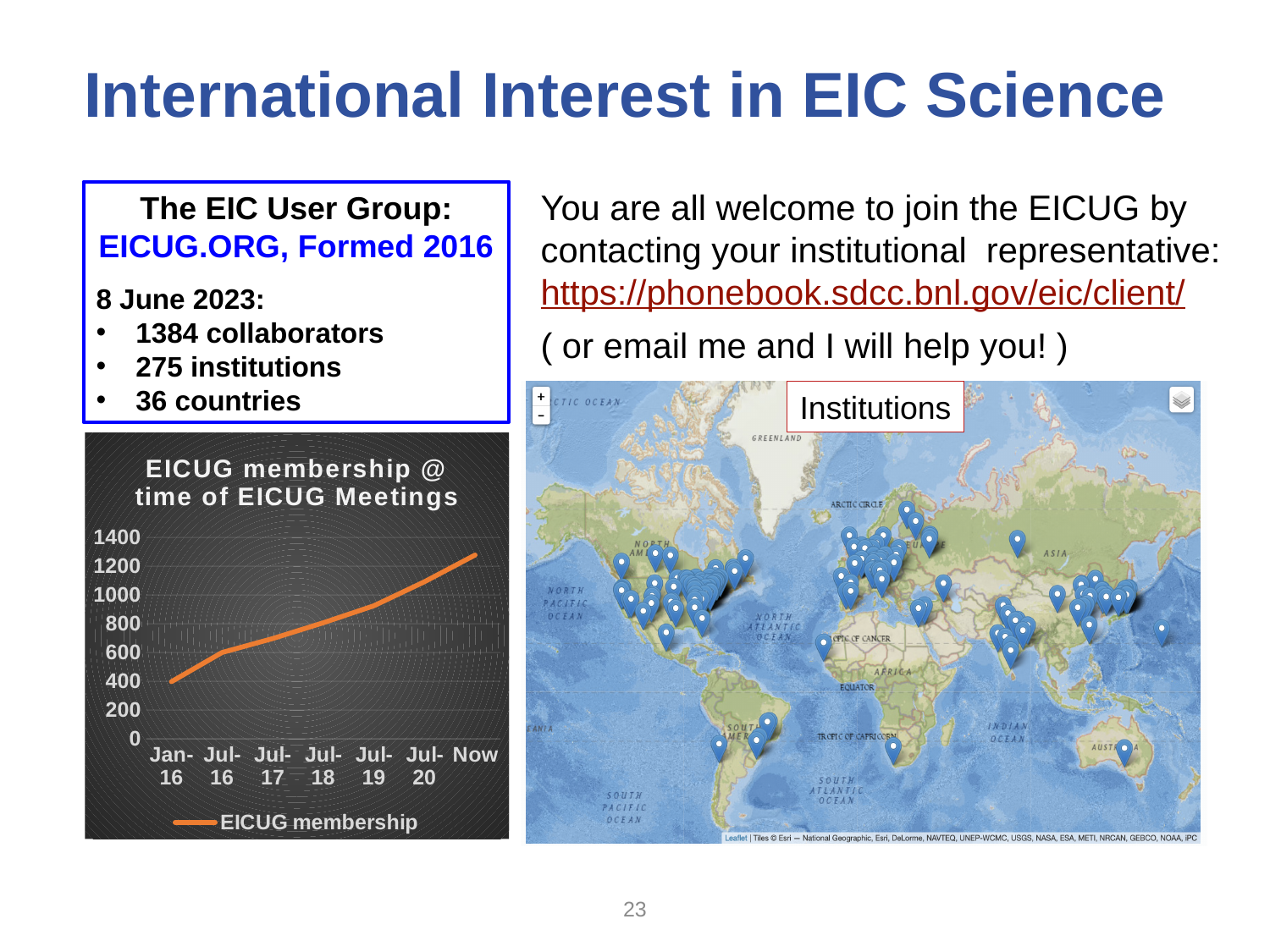
In the EICUG membership chart, which is larger, the value for Jul-20 or the value for Jul-17? Jul-20 In the EICUG membership chart, is the value for Now greater or less than 1200? greater What is the title of the chart on the left of the slide? EICUG membership @ time of EICUG Meetings In the EICUG membership chart, is the value for Jul-19 greater or less than 800? greater Which point on the EICUG membership chart has the lowest value? Jan-16 What kind of chart is the EICUG membership chart on the slide? line chart How many series does the legend of the EICUG membership chart list? 1 How many data points are plotted along the x axis of the EICUG membership chart? 7 Which point on the EICUG membership chart has the highest value? Now In the EICUG membership chart, is the value for Jan-16 greater or less than 600? less What is the legend entry of the EICUG membership chart? EICUG membership Do the values in the EICUG membership chart rise or fall from Jan-16 to Now? rise